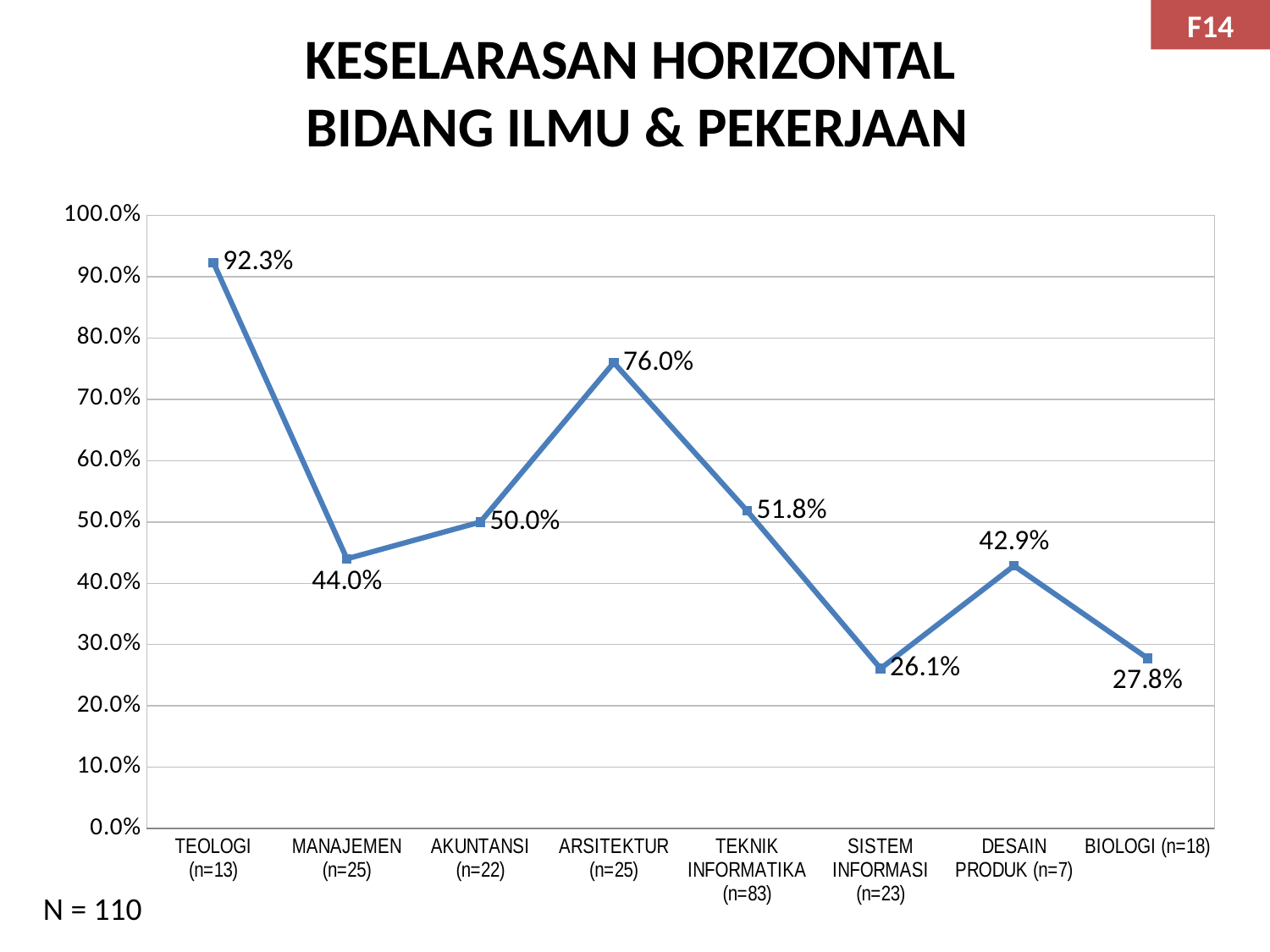
Which is larger, the value for AKUNTANSI (n=22) or the value for TEKNIK INFORMATIKA (n=83)? TEKNIK INFORMATIKA (n=83) Which category has the highest value? TEOLOGI (n=13) What kind of chart is shown on the slide? line chart Which category has the lowest value? SISTEM INFORMASI (n=23) What is the title of the chart on the slide? KESELARASAN HORIZONTAL BIDANG ILMU & PEKERJAAN What is the value for BIOLOGI (n=18)? 27.8% How many categories are plotted on the x axis? 8 What is the value for SISTEM INFORMASI (n=23)? 26.1% Is the value for DESAIN PRODUK (n=7) greater or less than 50.0%? less What is the value for ARSITEKTUR (n=25)? 76.0% What is the difference between the values for TEOLOGI (n=13) and MANAJEMEN (n=25)? 48.3% What is the value for TEOLOGI (n=13)? 92.3%